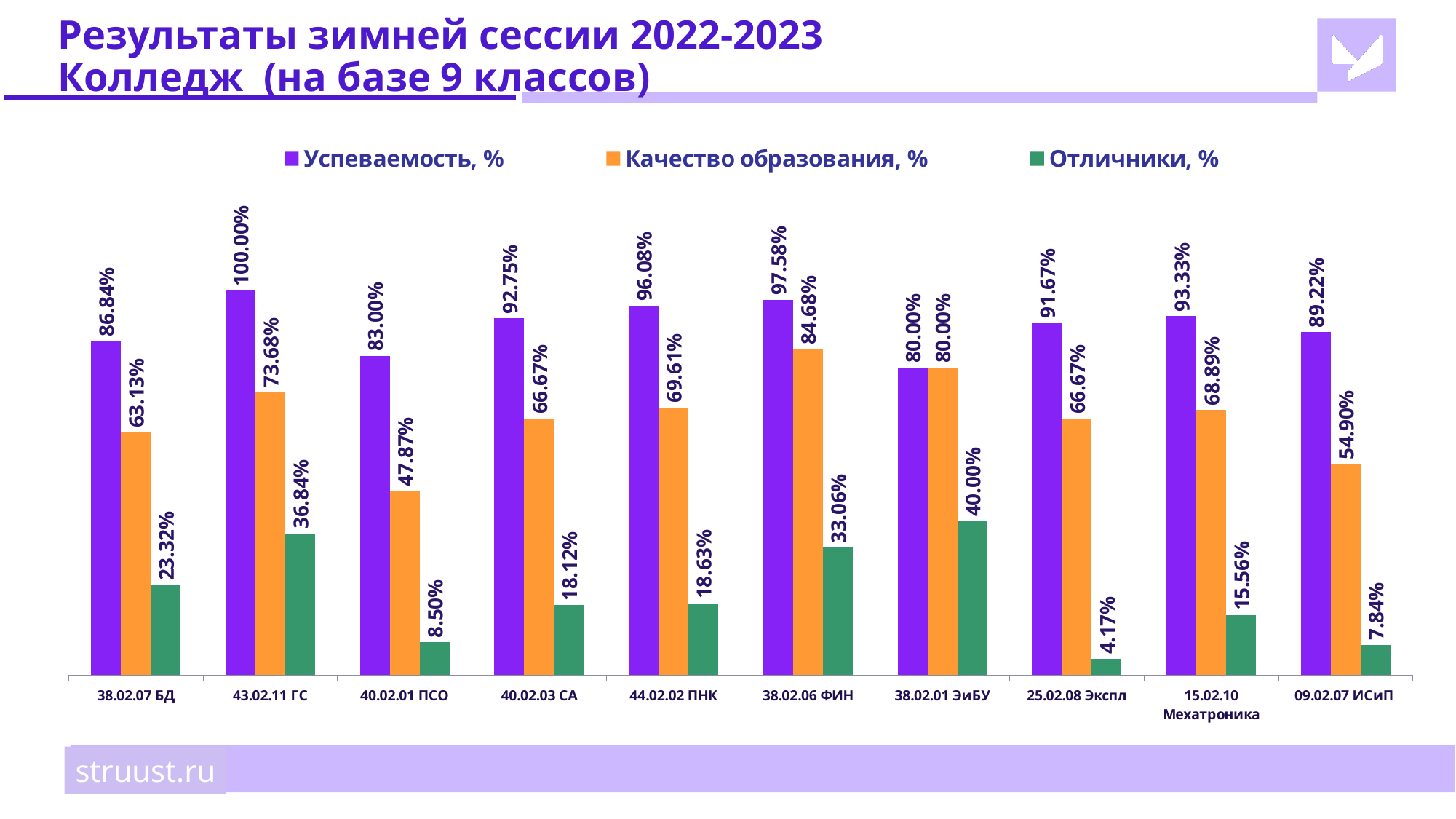
Which series is shown in orange in the legend? Качество образования, % What is the difference between Успеваемость, % and Качество образования, % for 09.02.07 ИСиП? 34.32% What is the value of Качество образования, % for 40.02.01 ПСО? 47.87% Which category has the lowest Отличники, %? 25.02.08 Экспл What is the value of Отличники, % for 15.02.10 Мехатроника? 15.56% What is the value of Успеваемость, % for 38.02.07 БД? 86.84% How many series does the legend list? 3 Which category has the highest Качество образования, %? 38.02.06 ФИН Which category has the highest Успеваемость, %? 43.02.11 ГС Which is larger: Отличники, % for 43.02.11 ГС or for 38.02.06 ФИН? 43.02.11 ГС What kind of chart is shown on the slide? Bar chart How many categories are shown on the x axis? 10